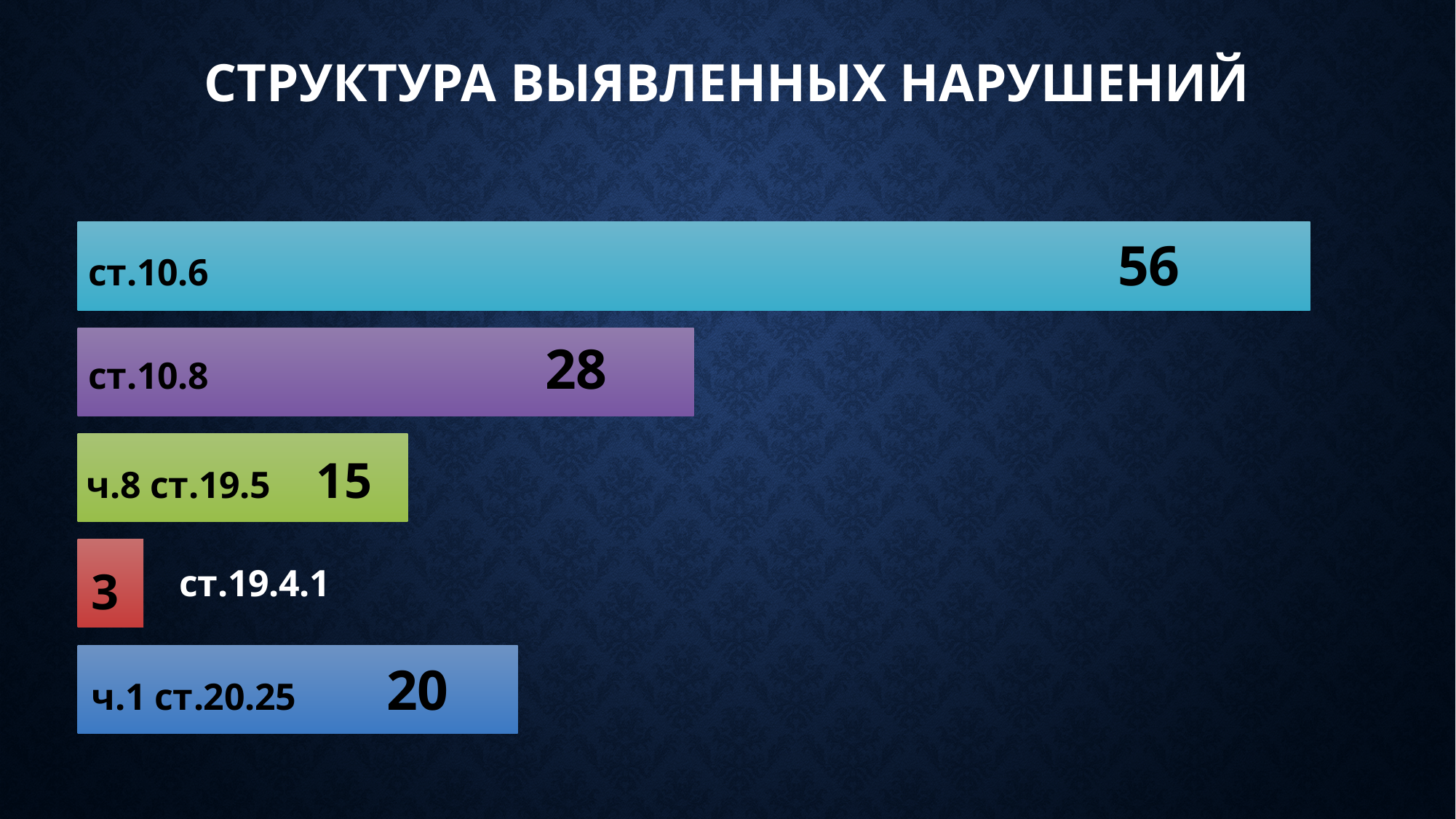
What is the value for ст.19.4.1? 3 Which category has the lowest value? ст.19.4.1 What is the difference between the values for ст.10.6 and ст.10.8? 28 Which is larger, the value for ч.1 ст.20.25 or the value for ч.8 ст.19.5? ч.1 ст.20.25 What is the value for ч.1 ст.20.25? 20 What is the value for ст.10.8? 28 What is the value for ст.10.6? 56 How many categories are shown in the chart? 5 What is the value for ч.8 ст.19.5? 15 Which category has the highest value? ст.10.6 What is the title of the chart? СТРУКТУРА ВЫЯВЛЕННЫХ НАРУШЕНИЙ What kind of chart is shown on the slide? Bar chart